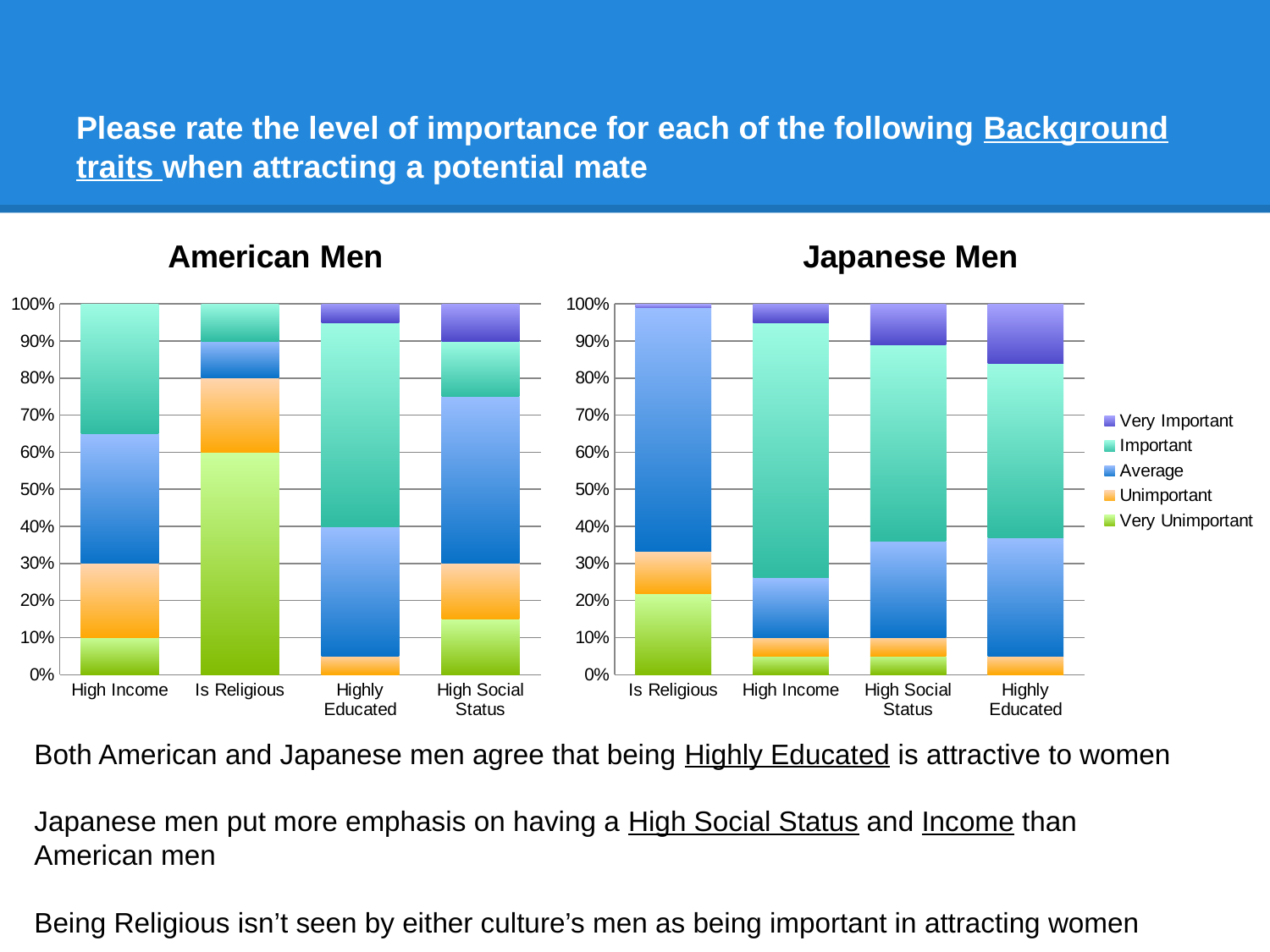
In the American Men chart, is the Very Unimportant value for High Income greater or less than 20%? less How many categories are shown on the x axis of the Japanese Men chart? 4 How many series does the legend list? 5 In the Japanese Men chart, is the Important value for High Income greater or less than 50%? greater In the Japanese Men chart, is the Average value for Is Religious greater or less than 50%? greater In the Japanese Men chart, which is larger, the Very Important segment for Highly Educated or for High Income? Highly Educated In the American Men chart, what is the total of the stacked bar for High Income? 100% Which legend entry is shown in purple? Very Important How many categories are shown on the x axis of the American Men chart? 4 What kind of chart is the American Men chart? Stacked bar chart In the American Men chart, which category has the largest Very Unimportant segment? Is Religious